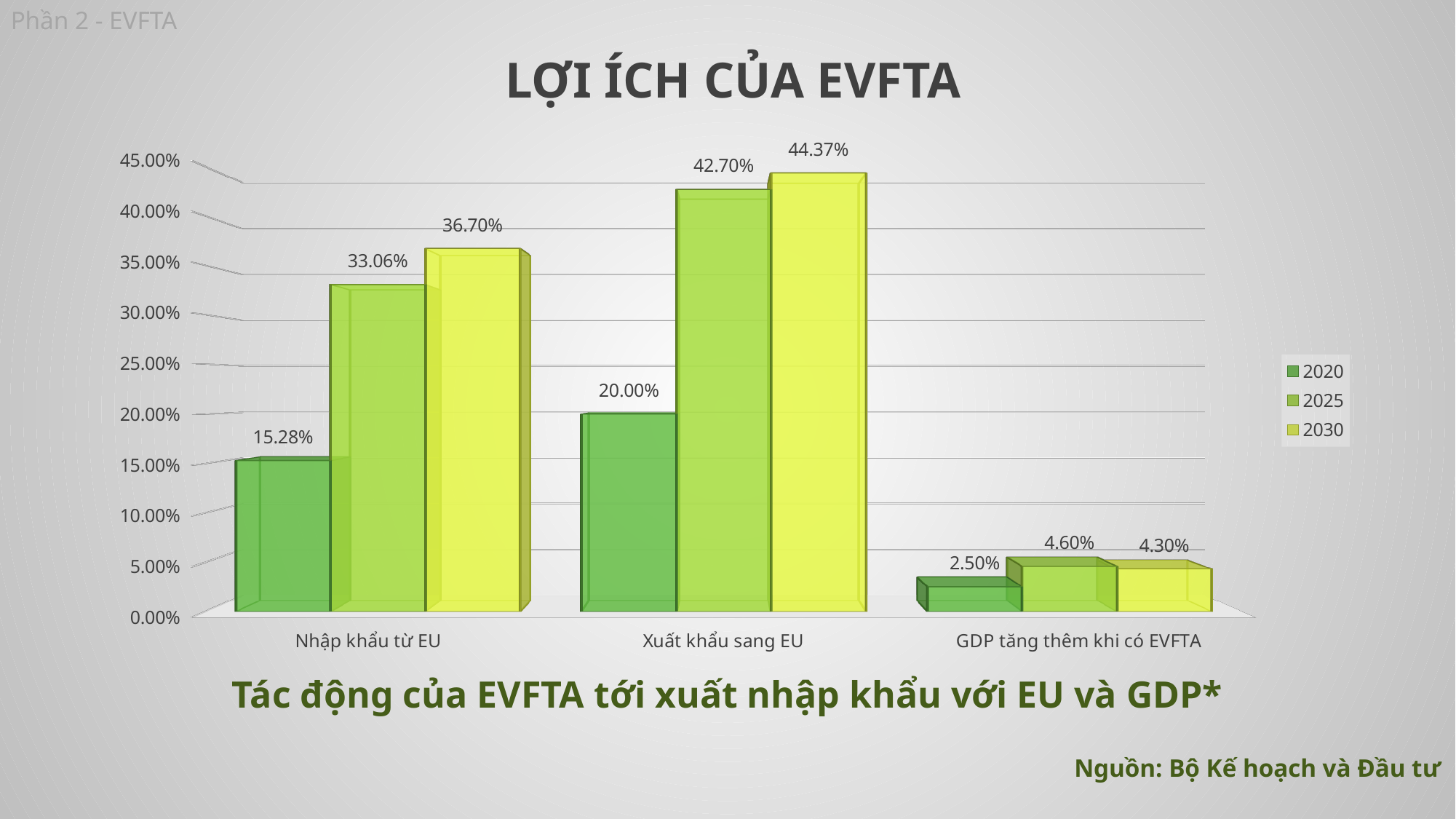
Which category has the lowest value for the 2020 series? GDP tăng thêm khi có EVFTA Which category has the highest value for the 2030 series? Xuất khẩu sang EU What is the value for 2020 in the "Nhập khẩu từ EU" category? 15.28% Is the 2025 value for "Nhập khẩu từ EU" greater or less than 30.00%? greater What is the difference between the 2030 and 2020 values for "Xuất khẩu sang EU"? 24.37% What is the value for 2025 in the "GDP tăng thêm khi có EVFTA" category? 4.60% What is the value for 2030 in the "Xuất khẩu sang EU" category? 44.37% How many categories are shown on the x axis? 3 What is the title of the chart? LỢI ÍCH CỦA EVFTA Which is larger in the "GDP tăng thêm khi có EVFTA" category: the 2025 value or the 2030 value? 2025 What kind of chart is shown on the slide? bar chart How many series does the legend list? 3